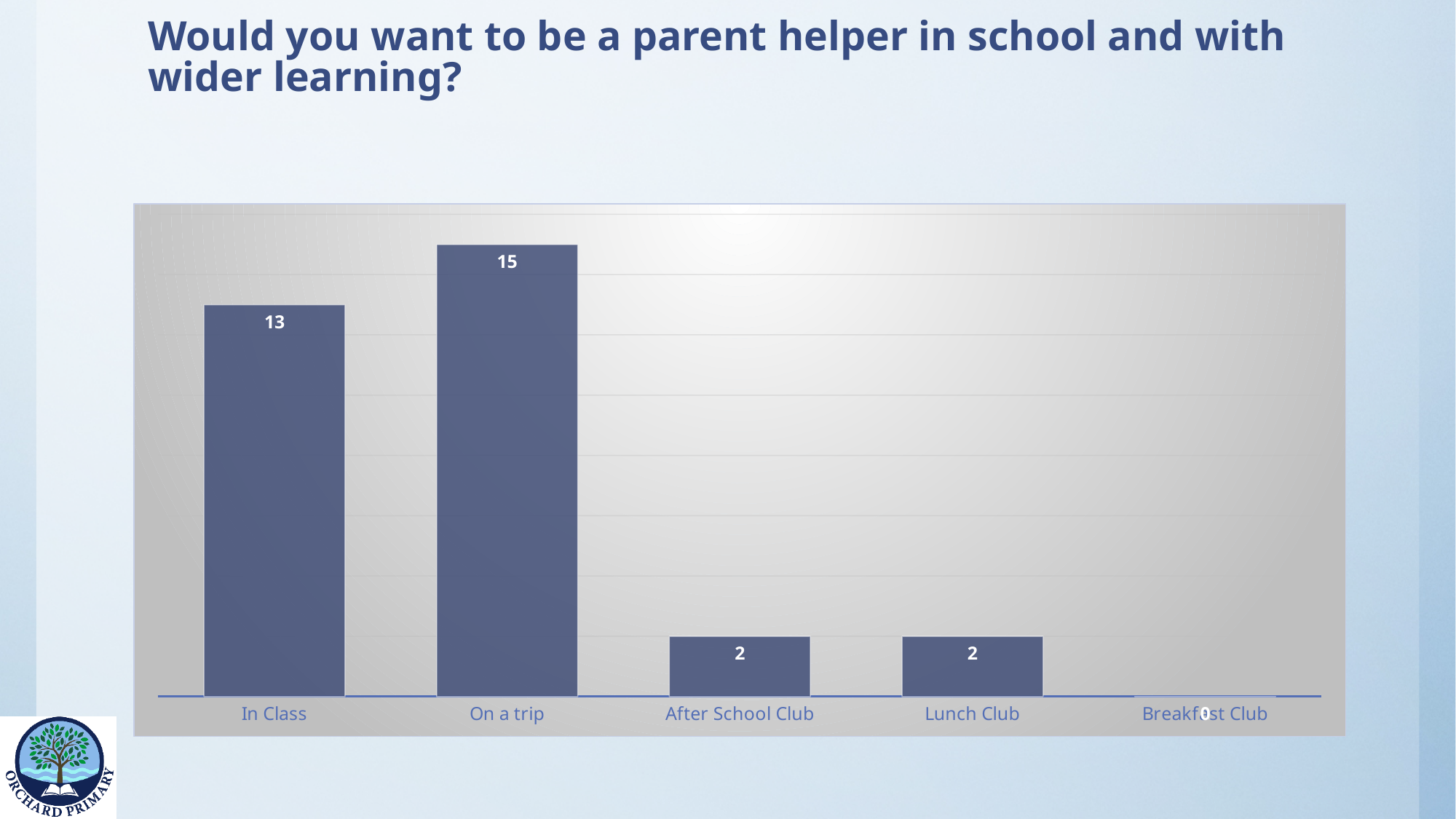
What is the difference between the values for On a trip and In Class? 2 What is the value for In Class? 13 What is the value for On a trip? 15 What is the value for After School Club? 2 How many categories are shown on the x axis? 5 Which category has the lowest value? Breakfast Club What is the title of the slide above the chart? Would you want to be a parent helper in school and with wider learning? What is the difference between the values for In Class and Lunch Club? 11 Which is larger, the value for In Class or the value for On a trip? On a trip What is the value for Breakfast Club? 0 Which category has the highest value? On a trip What kind of chart is shown on the slide? bar chart